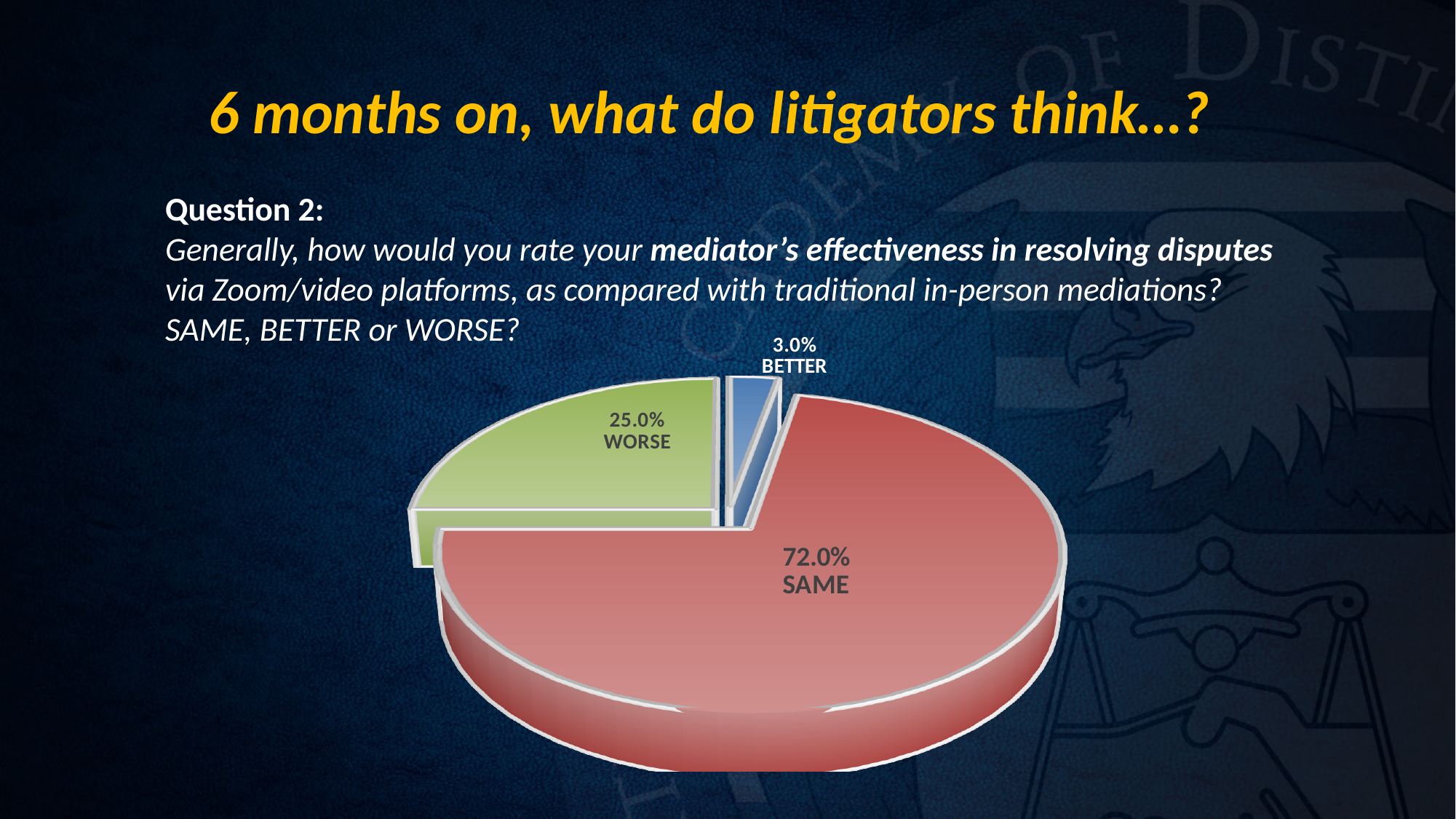
What colour is the SAME slice of the pie chart? red What percentage of litigators rated their mediator's effectiveness via Zoom as BETTER? 3.0% Which is larger, the WORSE slice or the BETTER slice? WORSE What colour is the WORSE slice of the pie chart? green What is the difference in percentage points between the SAME and WORSE slices? 47.0 Which response has the largest share of the pie? SAME What percentage of litigators rated their mediator's effectiveness via Zoom as SAME? 72.0% Which response has the smallest share of the pie? BETTER What is the difference in percentage points between the WORSE and BETTER slices? 22.0 How many slices does the pie chart have? 3 What kind of chart is shown on the slide? pie chart What percentage of litigators rated their mediator's effectiveness via Zoom as WORSE? 25.0%